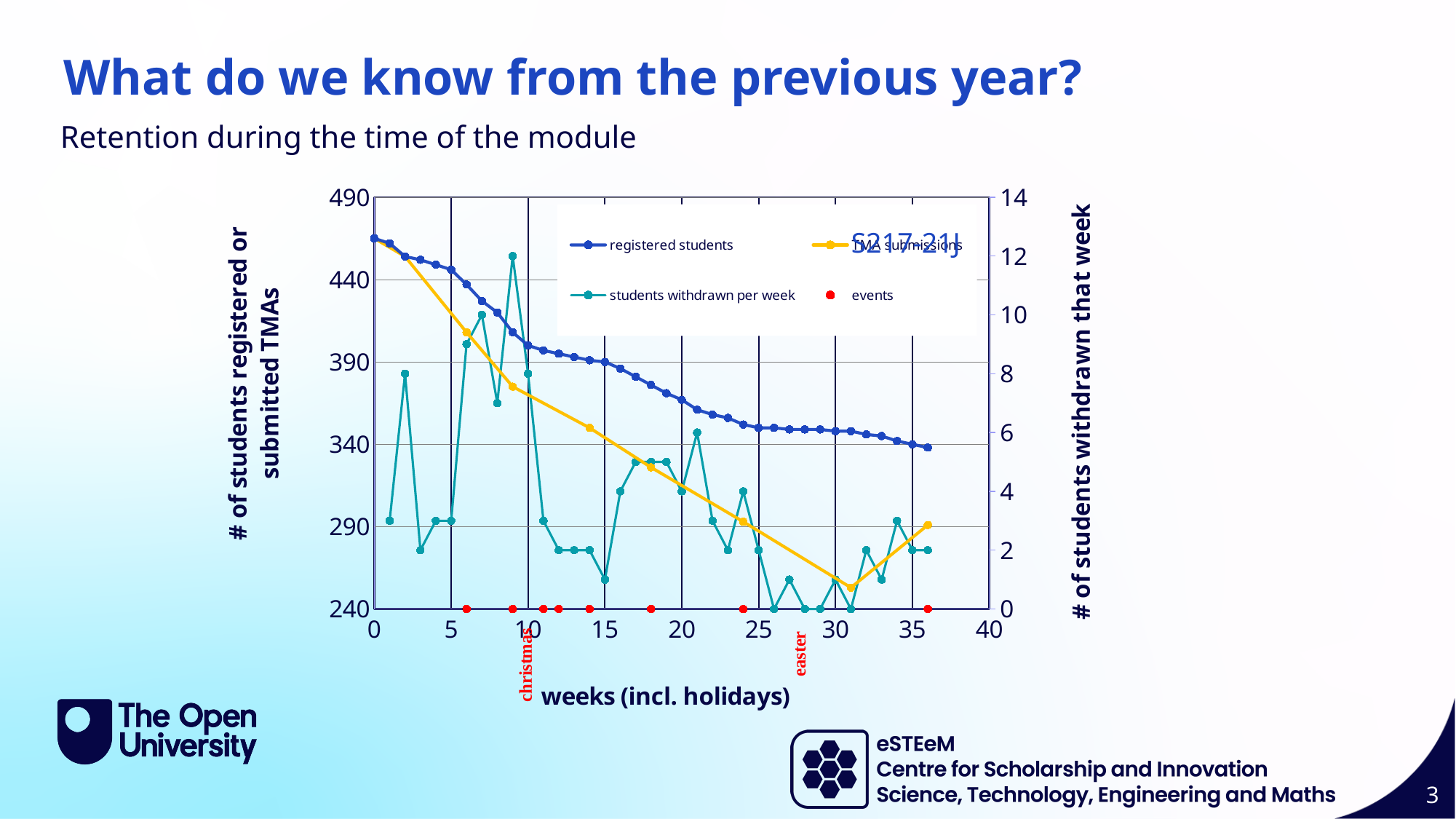
Which is larger: the number of registered students at week 0 or at week 36? week 0 Is the number of students withdrawn in week 9 greater or less than 10? greater What kind of chart is shown on the slide? line chart Is the number of registered students at week 0 greater or less than 440? greater Which week has more students withdrawn: week 9 or week 2? week 9 Is the number of registered students at week 36 greater or less than 390? less In which week is the number of students withdrawn per week highest? week 9 How many series does the chart legend list? 4 What is the title of the x axis of the chart? weeks (incl. holidays) Which two holidays are annotated in red below the x axis? christmas and easter Does the number of registered students rise or fall over the weeks of the module? fall